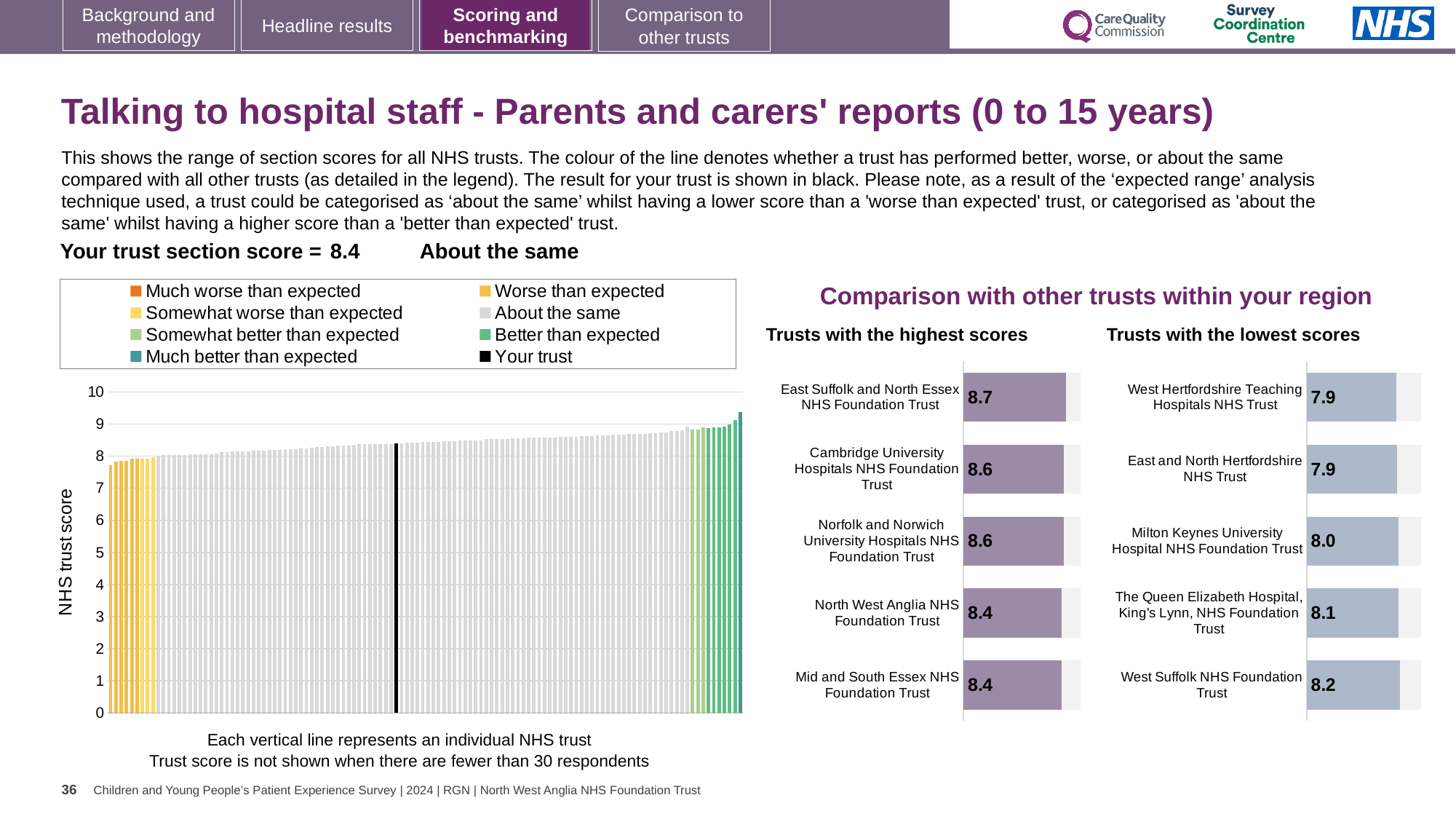
In the 'Trusts with the lowest scores' chart, which trust has the highest score shown? West Suffolk NHS Foundation Trust In the 'Trusts with the highest scores' chart, what is the score for East Suffolk and North Essex NHS Foundation Trust? 8.7 What kind of chart is the NHS trust score chart on the left of the slide? Bar chart In the NHS trust score chart on the left, is the value for the black 'Your trust' bar greater or less than 8? greater How many trusts are listed in the 'Trusts with the lowest scores' chart? 5 In the 'Trusts with the lowest scores' chart, what is the score for West Suffolk NHS Foundation Trust? 8.2 In the 'Trusts with the lowest scores' chart, which has the larger score: The Queen Elizabeth Hospital, King's Lynn, NHS Foundation Trust or West Hertfordshire Teaching Hospitals NHS Trust? The Queen Elizabeth Hospital, King's Lynn, NHS Foundation Trust In the 'Trusts with the highest scores' chart, which trust has the highest score? East Suffolk and North Essex NHS Foundation Trust How many entries does the legend above the NHS trust score chart list? 8 In the 'Trusts with the lowest scores' chart, what is the score for Milton Keynes University Hospital NHS Foundation Trust? 8.0 In the 'Trusts with the highest scores' chart, what is the score for North West Anglia NHS Foundation Trust? 8.4 In the 'Trusts with the highest scores' chart, what is the difference between the scores of East Suffolk and North Essex NHS Foundation Trust and Mid and South Essex NHS Foundation Trust? 0.3